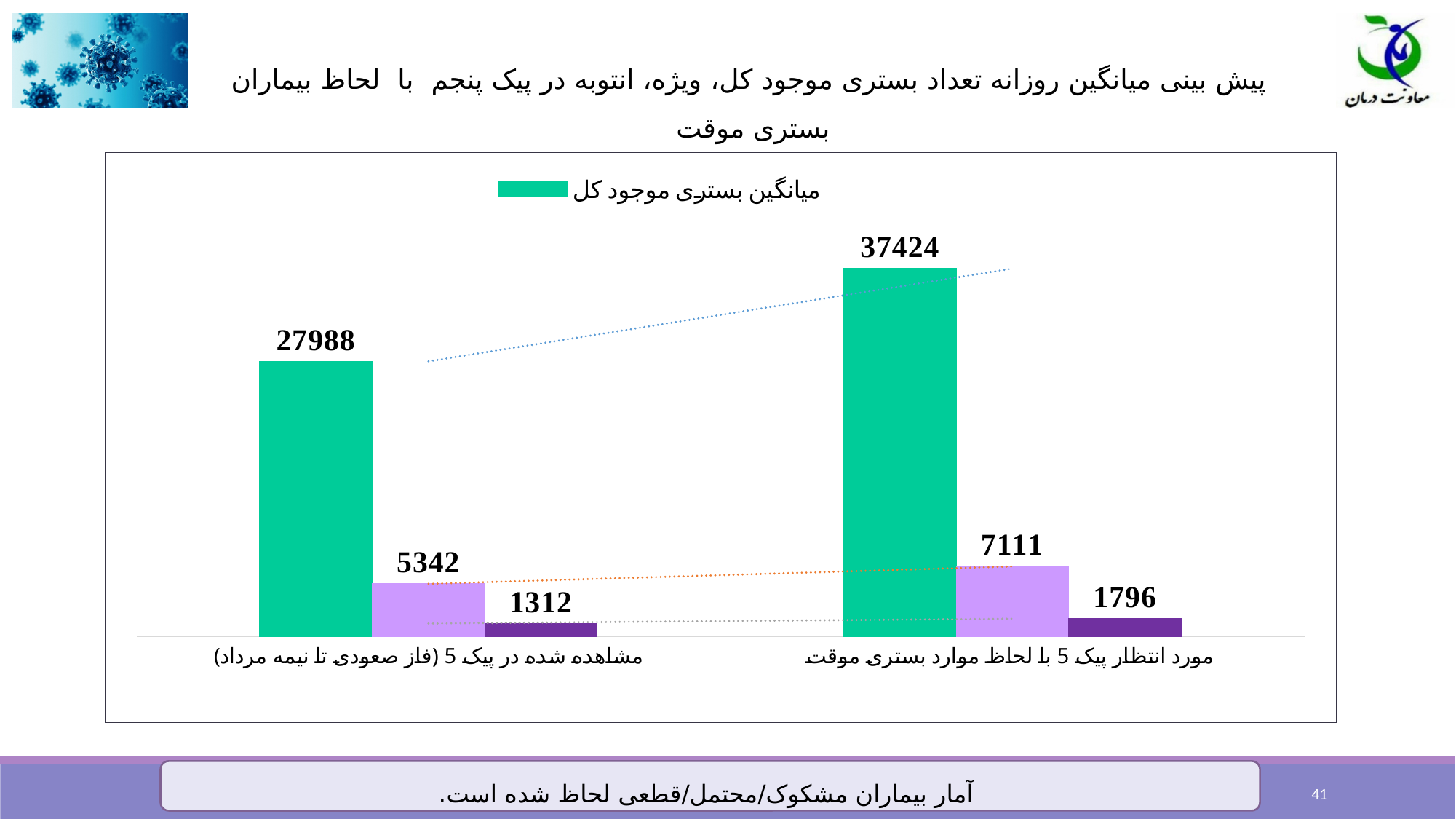
What is the value of the light purple bar for the category 'مشاهده شده در پیک 5 (فاز صعودی تا نیمه مرداد)'? 5342 Which category has the higher value for میانگین بستری موجود کل (green bars)? مورد انتظار پیک 5 با لحاظ موارد بستری موقت How many categories are shown on the x axis of the chart? 2 What is the value of the green bar (میانگین بستری موجود کل) for the category 'مورد انتظار پیک 5 با لحاظ موارد بستری موقت'? 37424 What is the value of the dark purple bar for the category 'مشاهده شده در پیک 5 (فاز صعودی تا نیمه مرداد)'? 1312 What is the value of the green bar (میانگین بستری موجود کل) for the category 'مشاهده شده در پیک 5 (فاز صعودی تا نیمه مرداد)'? 27988 Which is larger: the light purple bar for 'مورد انتظار پیک 5 با لحاظ موارد بستری موقت' or the light purple bar for 'مشاهده شده در پیک 5 (فاز صعودی تا نیمه مرداد)'? مورد انتظار پیک 5 با لحاظ موارد بستری موقت What is the legend entry shown above the chart? میانگین بستری موجود کل What is the difference between the green bar values of the two categories (37424 and 27988)? 9436 What is the difference between the light purple bar values of the two categories (7111 and 5342)? 1769 What type of chart is shown on the slide? bar chart What is the value of the dark purple bar for the category 'مورد انتظار پیک 5 با لحاظ موارد بستری موقت'? 1796